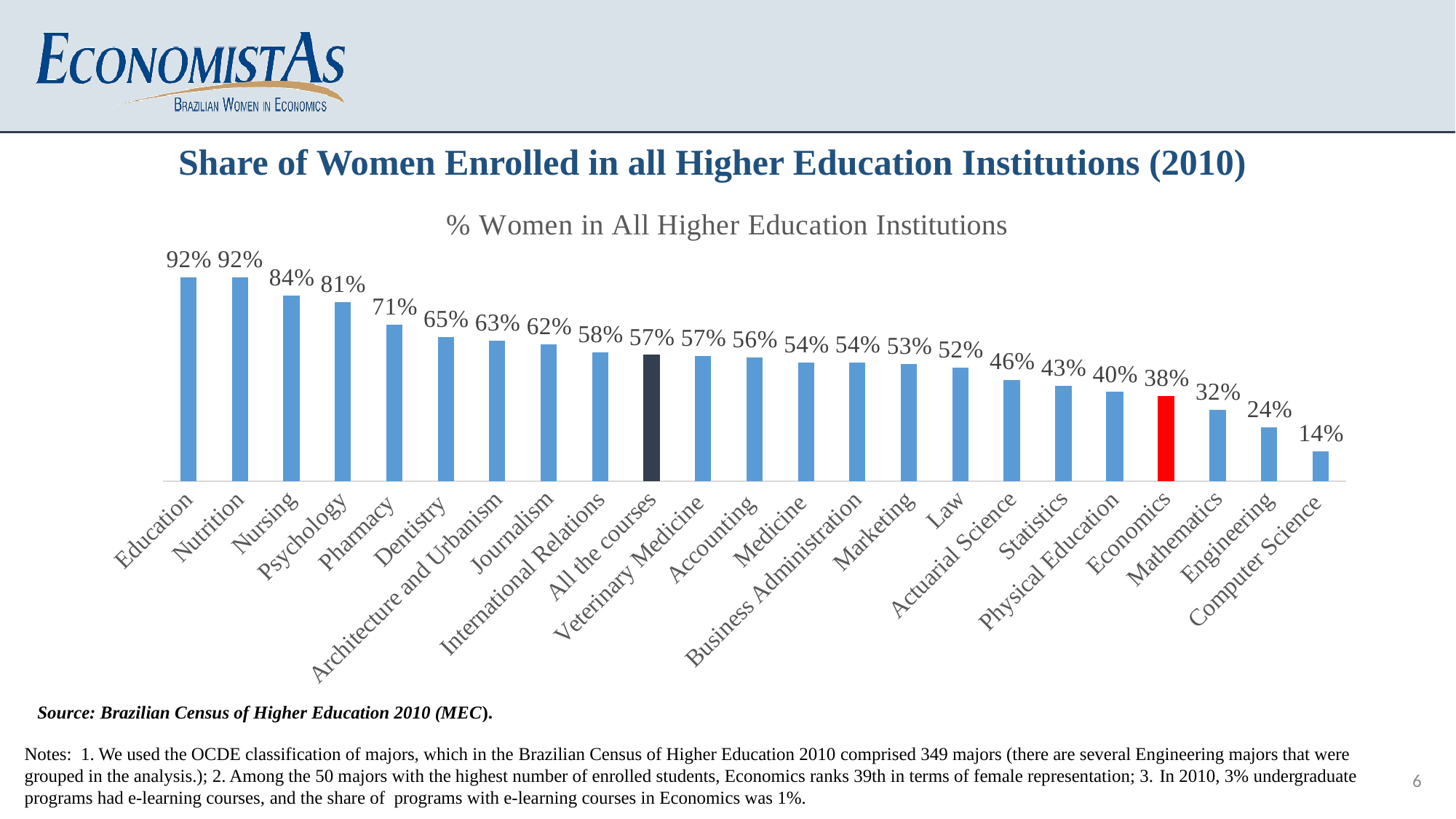
What is the difference between the value for Education and the value for Computer Science? 78 percentage points Which category has the lowest value? Computer Science What is the value for Law? 52% What is the difference between the value for All the courses and the value for Economics? 19 percentage points Do the values rise or fall from left to right along the x axis? Fall What kind of chart is shown on the slide? Bar chart Which is larger, the value for Statistics or the value for Mathematics? Statistics What is the value for Economics? 38% What is the value for All the courses? 57% What is the value for Computer Science? 14% How many categories are shown in the chart? 23 Which category's bar is coloured red? Economics